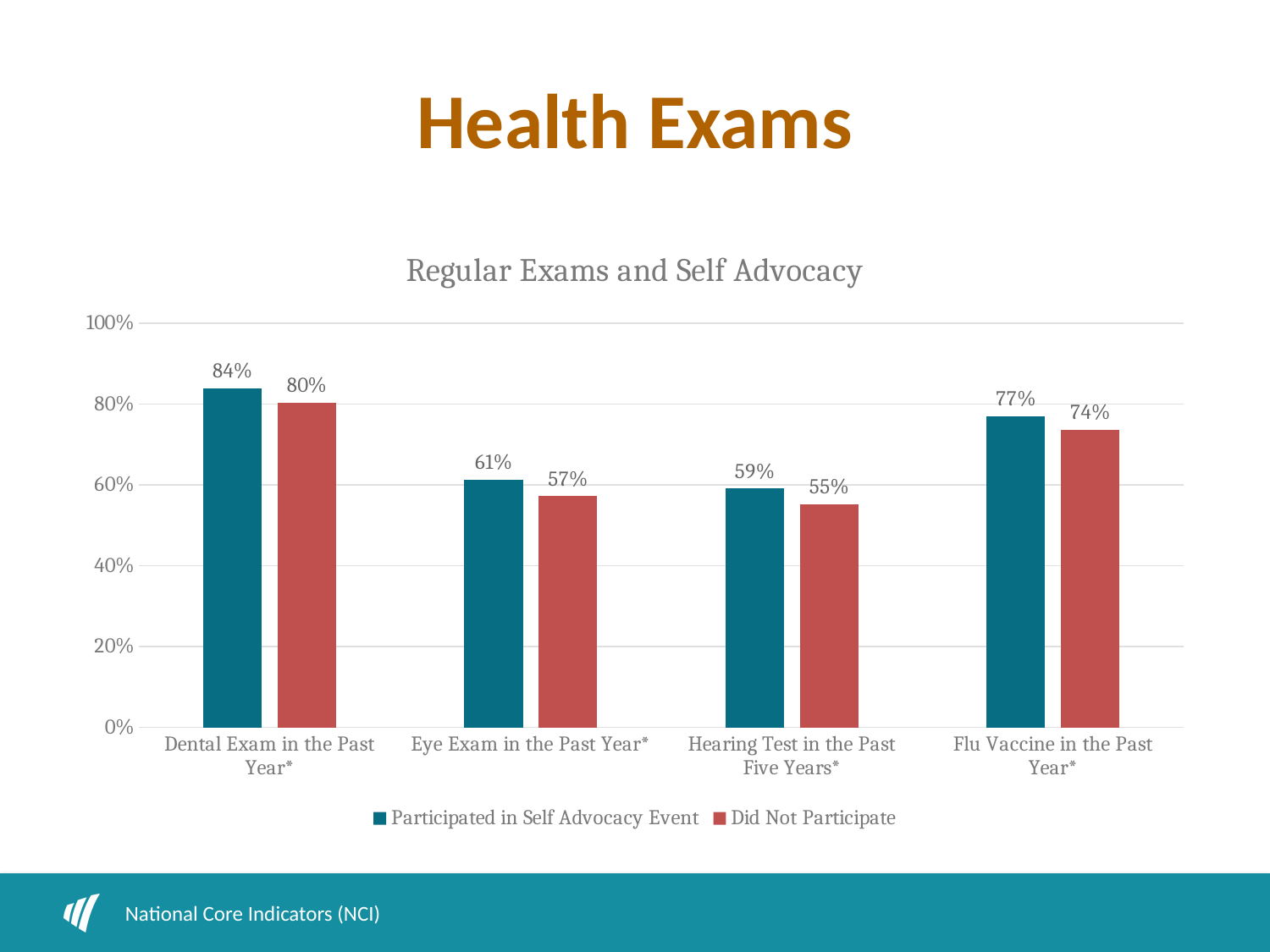
What is the value for 'Did Not Participate' for Flu Vaccine in the Past Year? 74% What type of chart is shown on the slide? Bar chart What is the value for 'Did Not Participate' for Eye Exam in the Past Year? 57% Is the 'Did Not Participate' value for Flu Vaccine in the Past Year greater or less than 60%? greater What is the difference between the two series for Dental Exam in the Past Year? 4% Which category has the highest value for 'Participated in Self Advocacy Event'? Dental Exam in the Past Year How many categories are shown on the x axis? 4 How many series does the legend list? 2 What percentage of those who participated in a self advocacy event had a dental exam in the past year? 84% What is the value for 'Participated in Self Advocacy Event' for Hearing Test in the Past Five Years? 59% Which category has the lowest value for 'Did Not Participate'? Hearing Test in the Past Five Years For Eye Exam in the Past Year, which series has the larger value? Participated in Self Advocacy Event